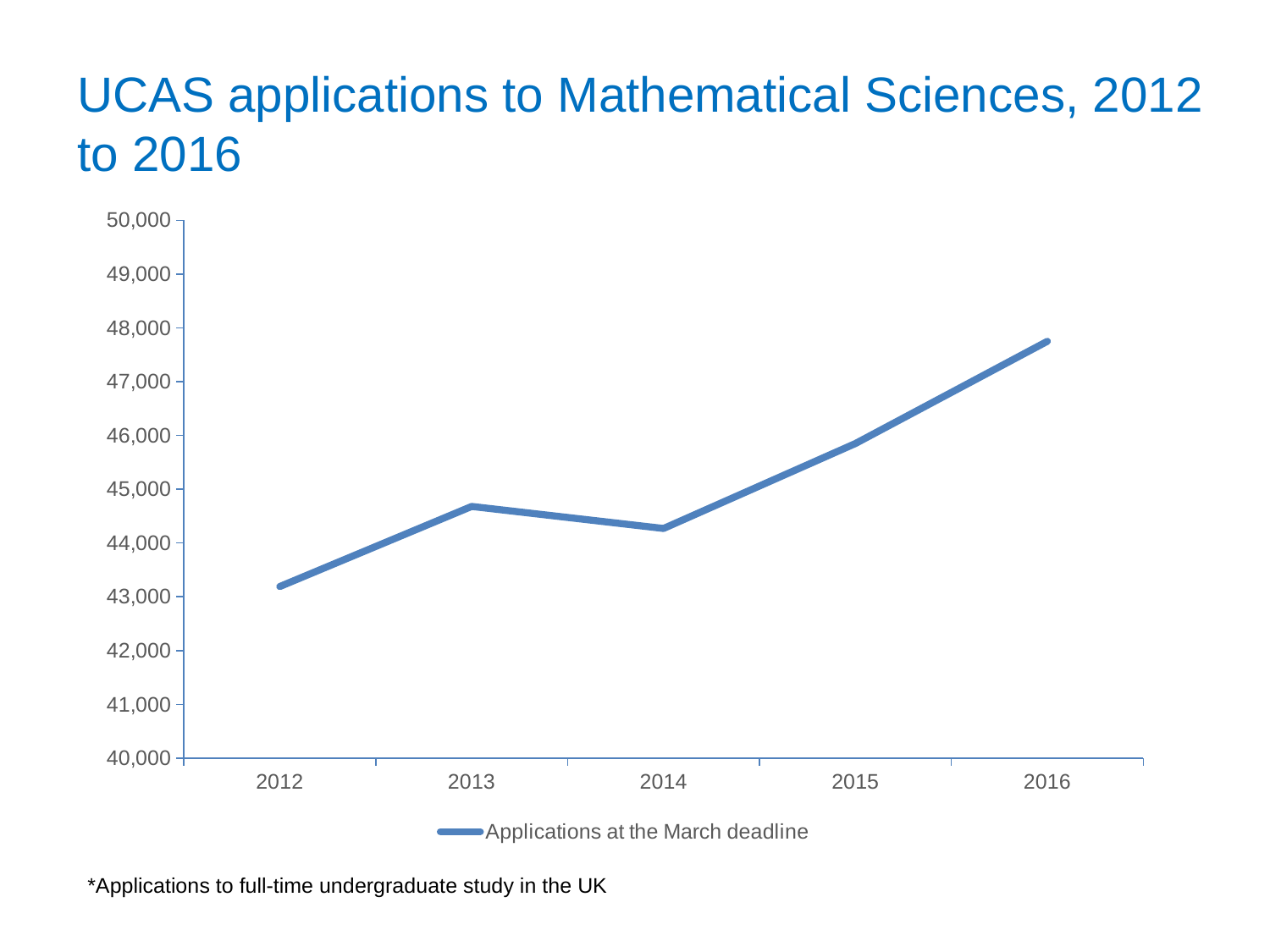
Is the value for 2015 greater or less than 45,000? greater Is the value for 2014 greater or less than 45,000? less Is the value for 2016 greater or less than 47,000? greater Which year has more applications, 2015 or 2013? 2015 How many years are plotted on the x axis? 5 Which year has the highest number of applications? 2016 Do applications overall rise or fall from 2012 to 2016? rise What is the series name shown in the legend? Applications at the March deadline Which year has the lowest number of applications? 2012 What kind of chart is shown on the slide? line chart How many series does the legend list? 1